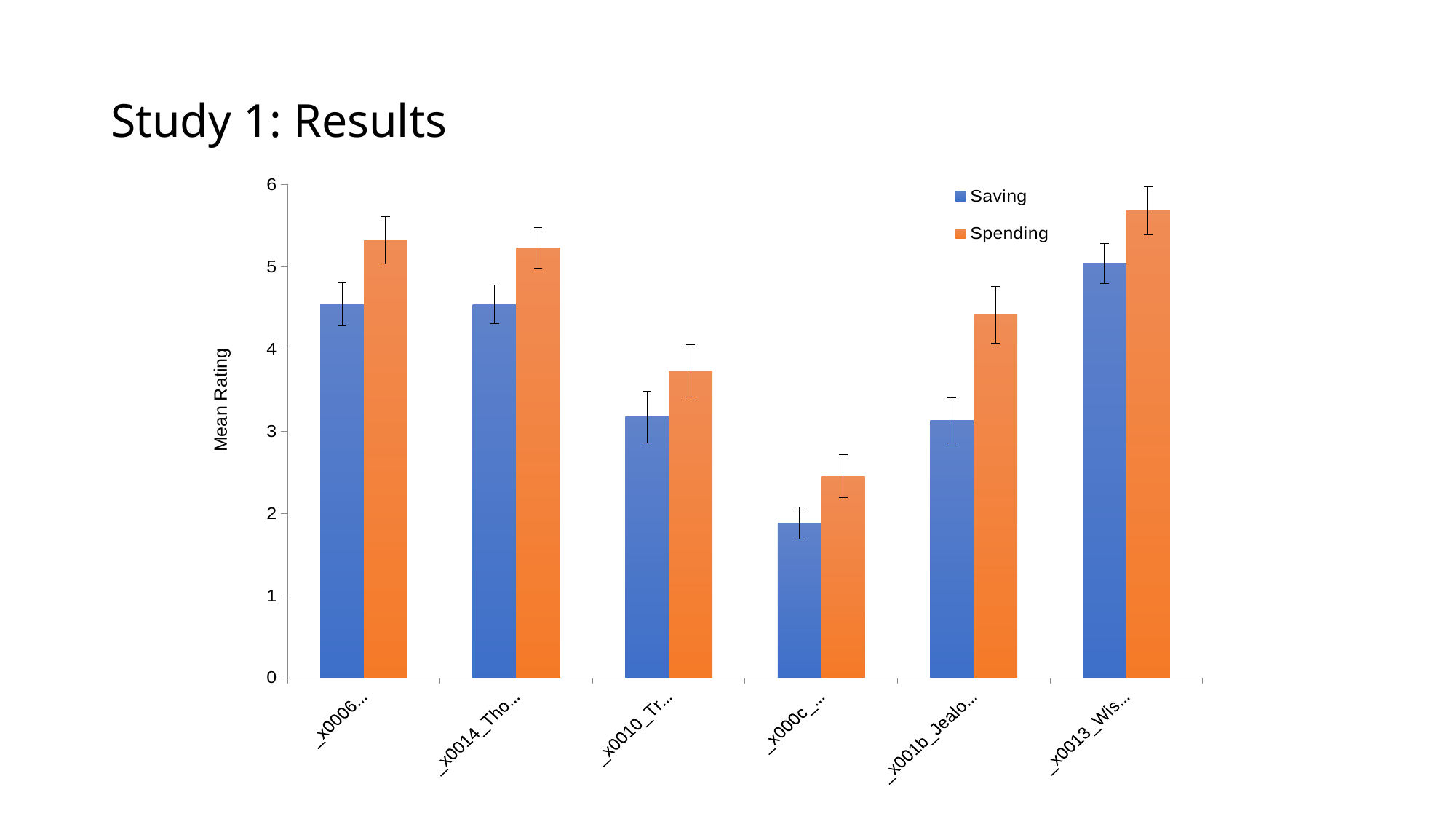
What kind of chart is shown on the slide? bar chart Which bar is the tallest in the chart? Spending for the sixth (rightmost) category Is the Saving value for the fourth category from the left greater or less than 2? less Is the Saving value for the first (leftmost) category greater or less than 4? greater How many series does the legend list? 2 Is the Spending value for the sixth (rightmost) category greater or less than 5? greater For the fifth category from the left, which is larger, the Saving value or the Spending value? Spending What is the label on the vertical axis? Mean Rating Which bar is the shortest in the chart? Saving for the fourth category How many categories are shown along the x axis? 6 What are the two series named in the legend? Saving and Spending